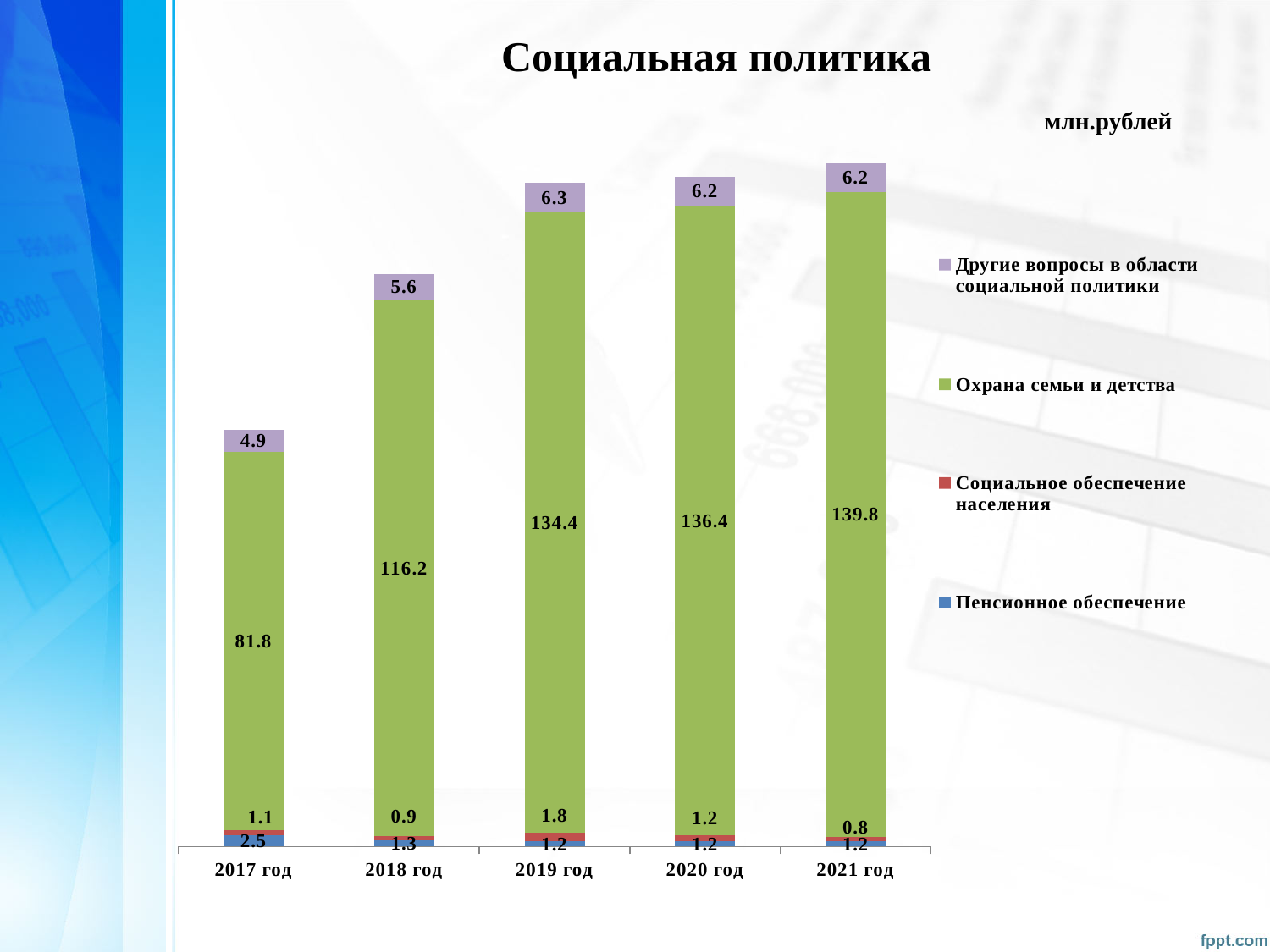
How many series does the legend list? 4 What type of chart is shown on the slide? stacked bar chart Which is larger: Другие вопросы в области социальной политики in 2019 год or in 2018 год? 2019 год What is the difference between the Охрана семьи и детства values for 2021 год and 2017 год? 58.0 What is the value for Социальное обеспечение населения in 2021 год? 0.8 In which year is the value for Социальное обеспечение населения the lowest? 2021 год What is the value for Охрана семьи и детства in 2019 год? 134.4 What is the value for Пенсионное обеспечение in 2018 год? 1.3 What is the value for Другие вопросы в области социальной политики in 2017 год? 4.9 What is the total of the stacked bar for 2017 год? 90.3 In which year is the value for Охрана семьи и детства the highest? 2021 год How many years are shown on the x axis? 5